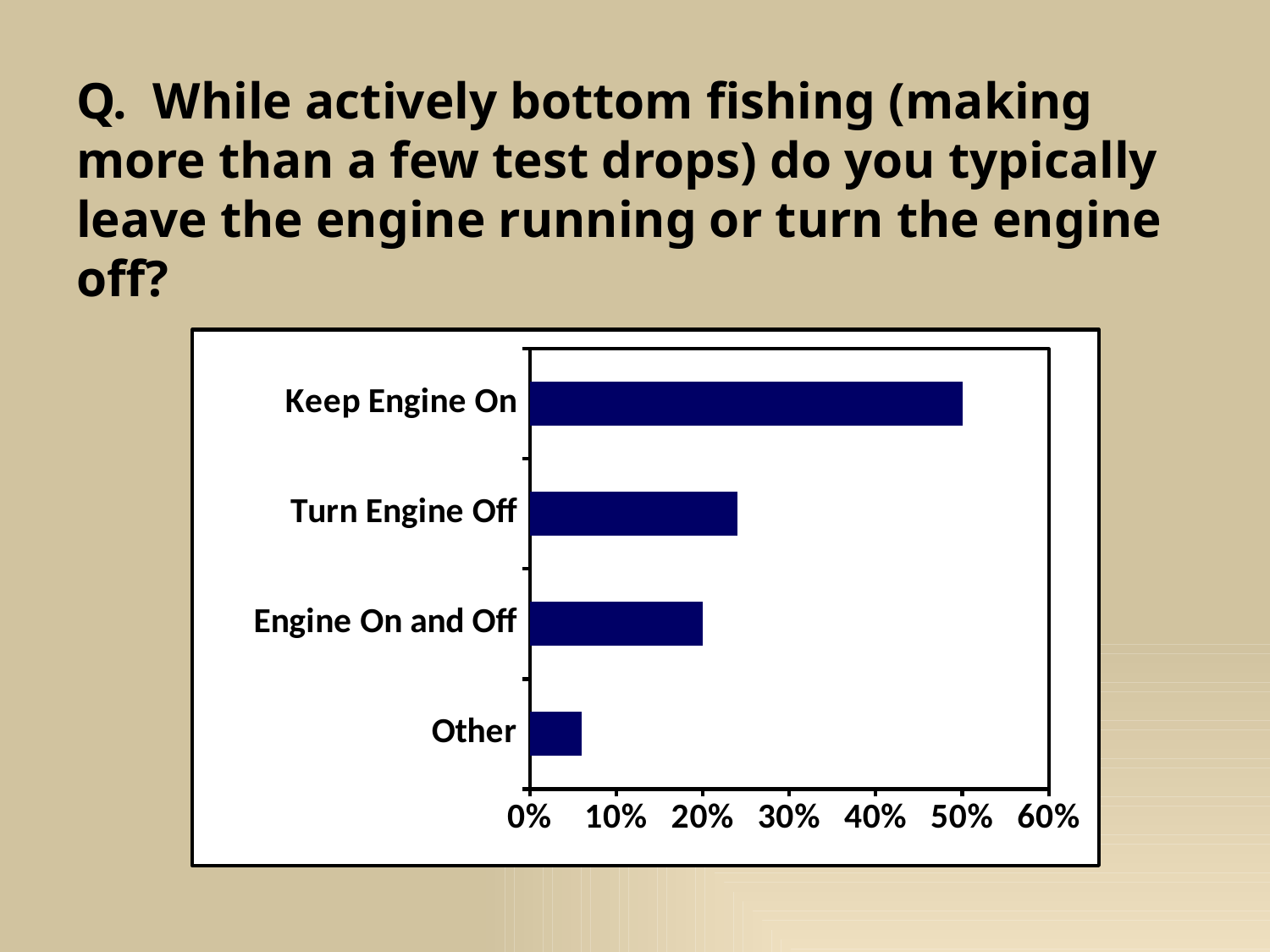
What kind of chart is shown on the slide? bar chart Is the value for Turn Engine Off greater or less than 20%? greater What is the highest value shown on the horizontal axis? 60% How many categories are shown in the chart? 4 Is the value for Other greater or less than 10%? less Which category has the highest value? Keep Engine On What is the value for Keep Engine On? 50% Which category has the lowest value? Other Is the value for Keep Engine On greater or less than 40%? greater Which is larger, the value for Keep Engine On or the value for Turn Engine Off? Keep Engine On Which is larger, the value for Turn Engine Off or the value for Engine On and Off? Turn Engine Off